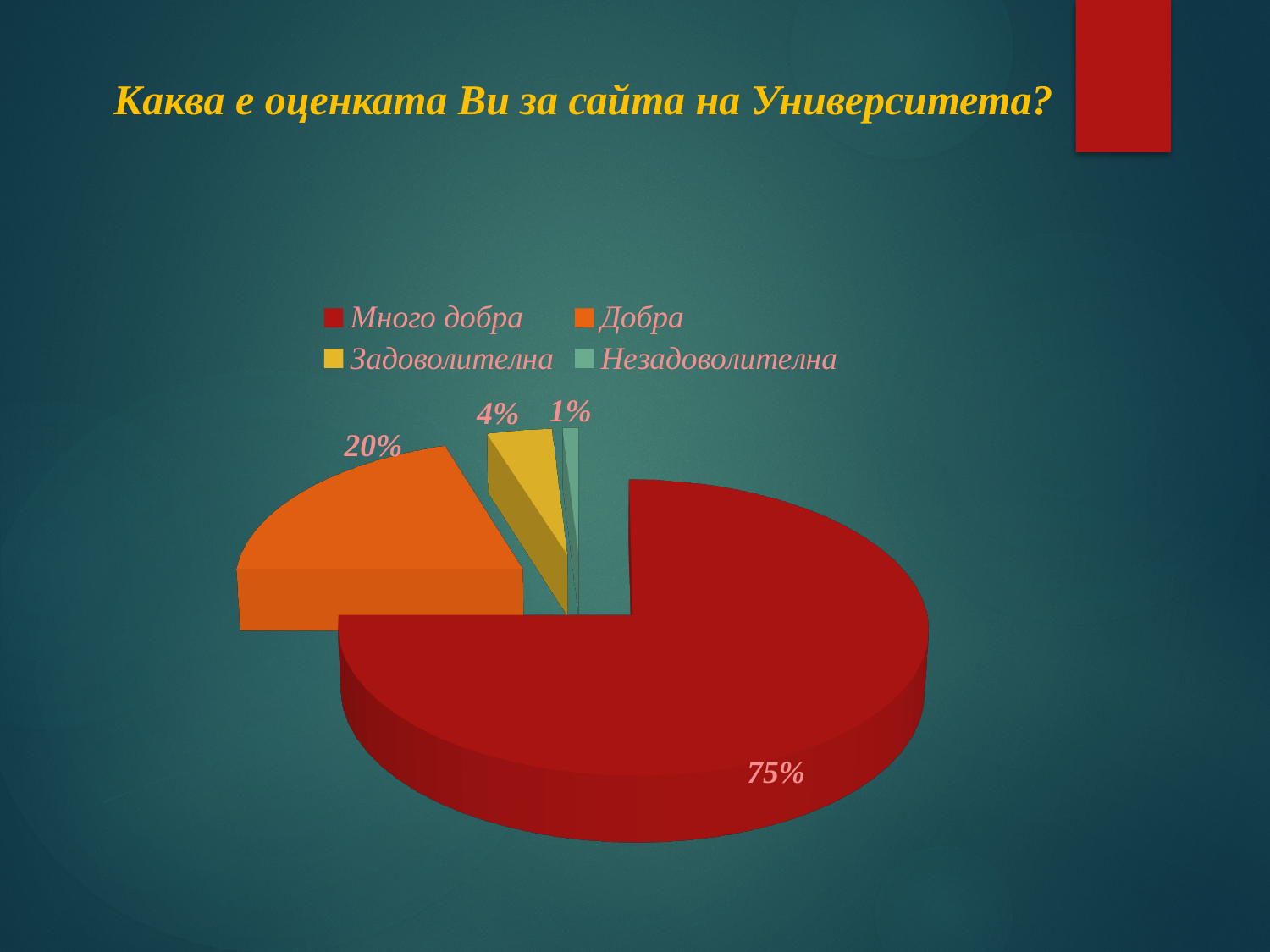
What kind of chart is shown on the slide? Pie chart What is the difference between the values for "Много добра" and "Добра"? 55% What is the value for "Добра"? 20% Which is larger, the value for "Добра" or the value for "Задоволителна"? Добра Which category has the largest slice? Много добра What is the value for "Незадоволителна"? 1% What colour is the slice for "Добра"? Orange What is the difference between the values for "Задоволителна" and "Незадоволителна"? 3% Which category has the smallest slice? Незадоволителна What share of the pie does "Много добра" represent? 75% How many categories does the pie chart show? 4 What is the value for "Задоволителна"? 4%